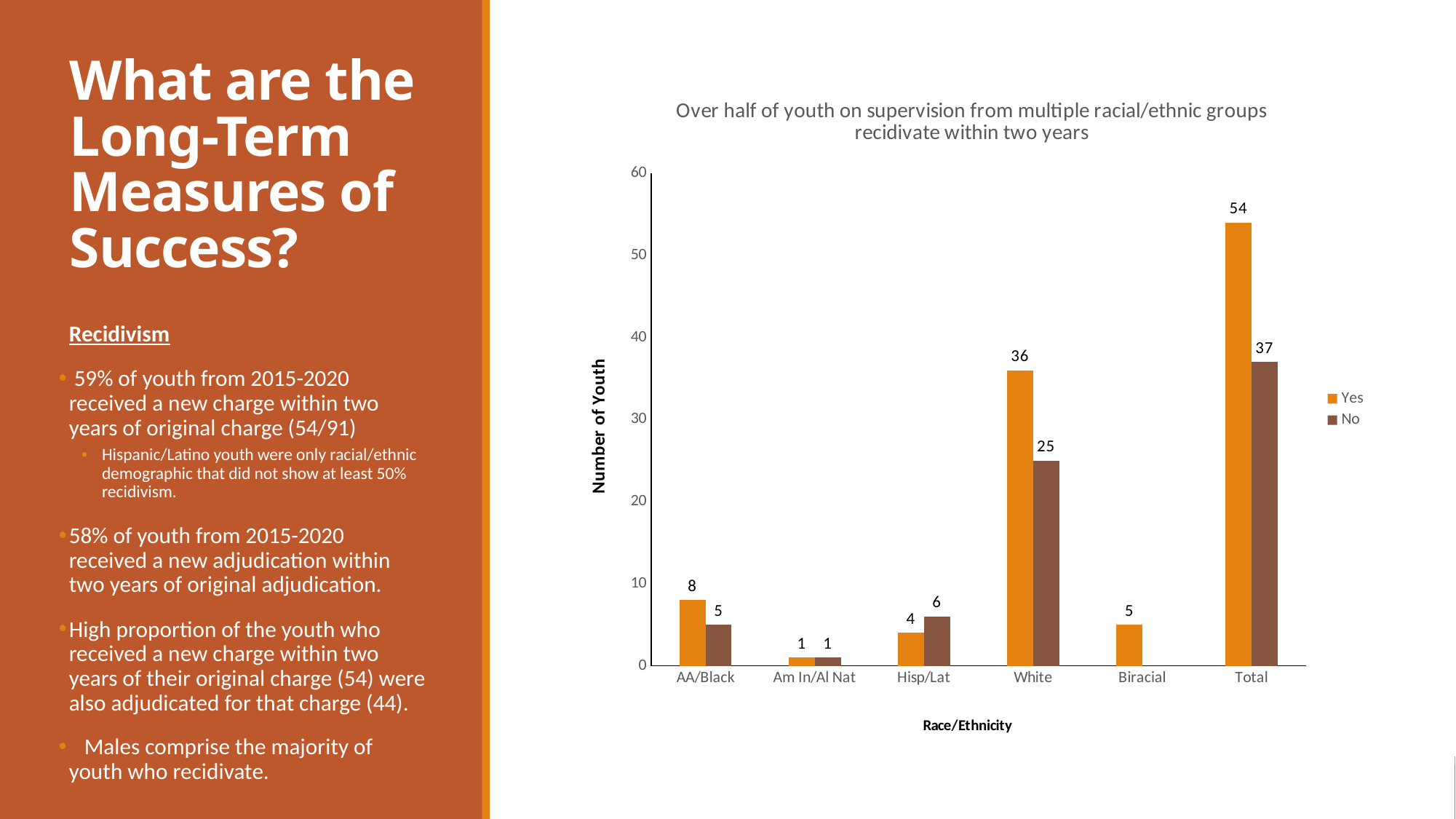
What is the value of the No series for Total? 37 For Hisp/Lat, which is larger, the Yes value or the No value? No How many series does the legend list? 2 How many race/ethnicity categories are shown on the x axis? 6 What kind of chart is shown on the slide? Bar chart What is the difference between the Yes and No values for White? 11 Which race/ethnicity category has the lowest Yes value? Am In/Al Nat What is the value of the No series for Hisp/Lat? 6 What is the value of the Yes series for White? 36 What is the value of the Yes series for AA/Black? 8 What is the label of the y axis? Number of Youth Excluding Total, which race/ethnicity category has the highest Yes value? White